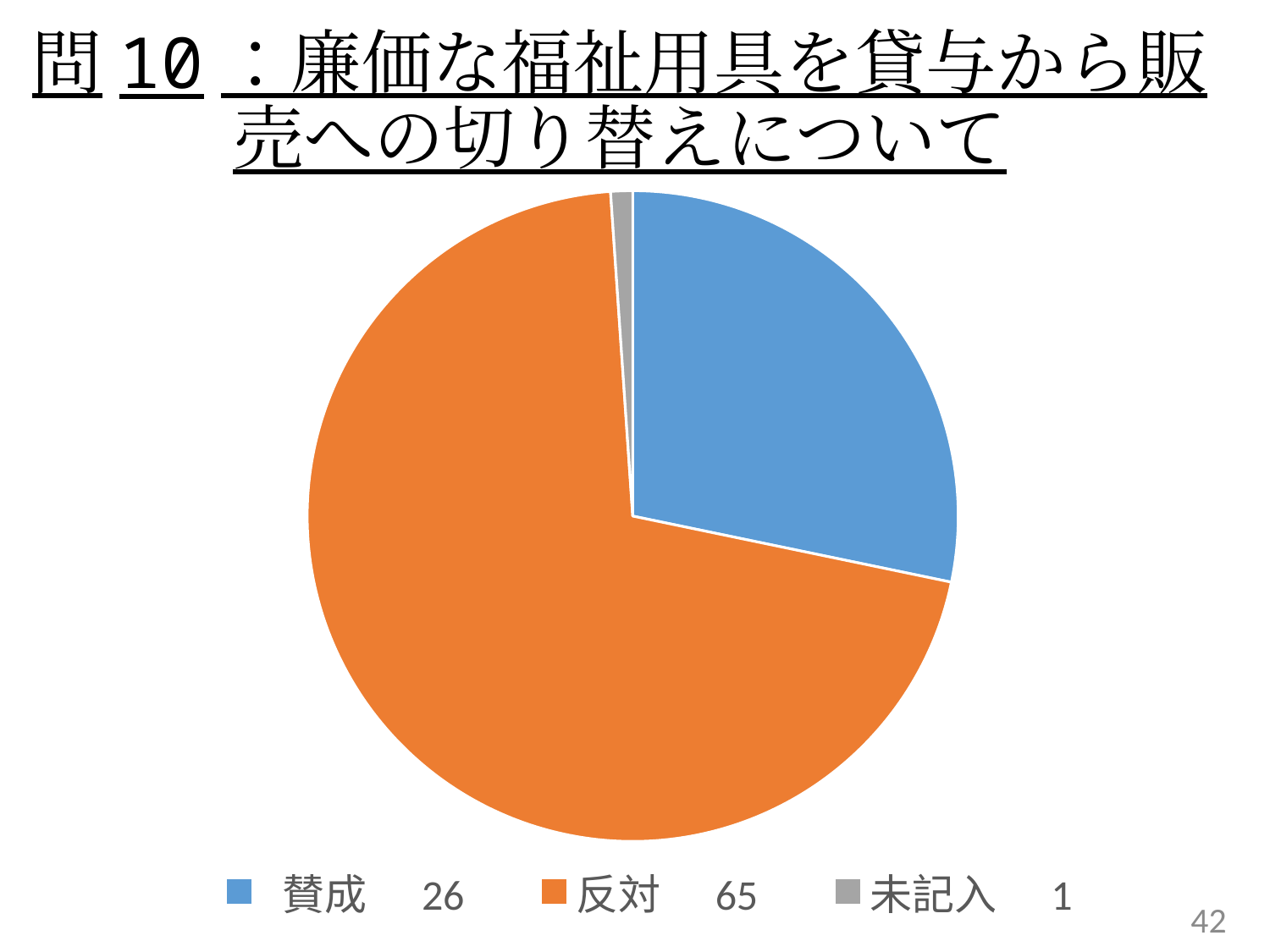
Which category has the largest slice of the pie? 反対 Which category has the smallest slice of the pie? 未記入 What is the value for 反対? 65 What is the value for 未記入? 1 What is the difference between the values for 反対 and 賛成? 39 What is the value for 賛成? 26 What colour is the slice for 賛成? blue What colour is the slice for 反対? orange Which is larger, the value for 賛成 or the value for 反対? 反対 How many categories does the pie chart have? 3 What kind of chart is shown on the slide? pie chart What is the total of all the values shown in the legend? 92